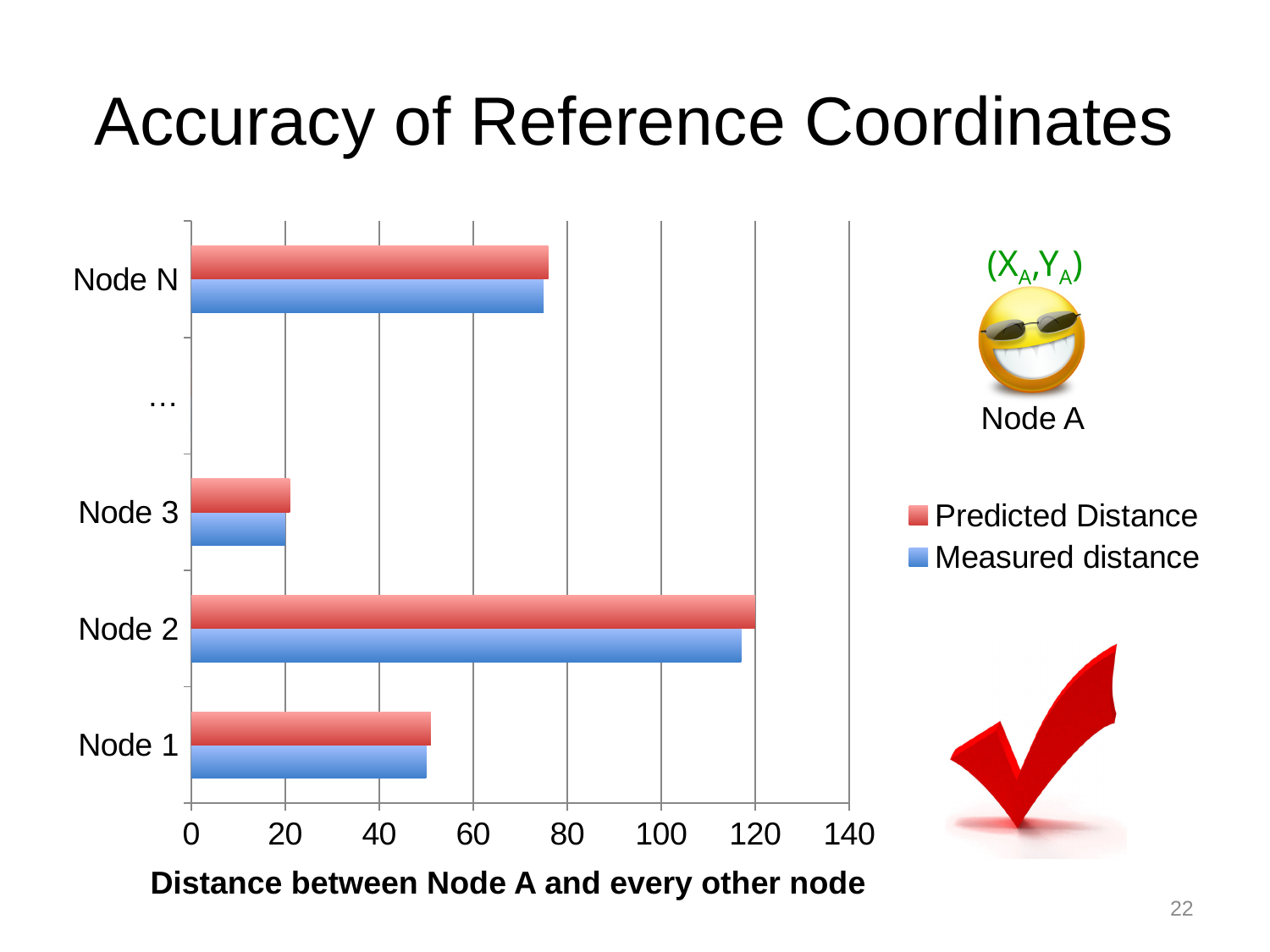
What kind of chart is shown on the slide? bar chart Which colour represents the Measured distance series in the chart? blue How many series does the chart's legend list? 2 Which node has the lowest Measured distance? Node 3 Is the Measured distance for Node 2 greater or less than 100? greater Is the Predicted Distance for Node 3 greater or less than 40? less Which has the larger Predicted Distance, Node 1 or Node N? Node N What is the title of the chart's horizontal axis? Distance between Node A and every other node Is the Measured distance for Node N greater or less than 60? greater Which node has the highest Predicted Distance? Node 2 Which has the larger Measured distance, Node 2 or Node N? Node 2